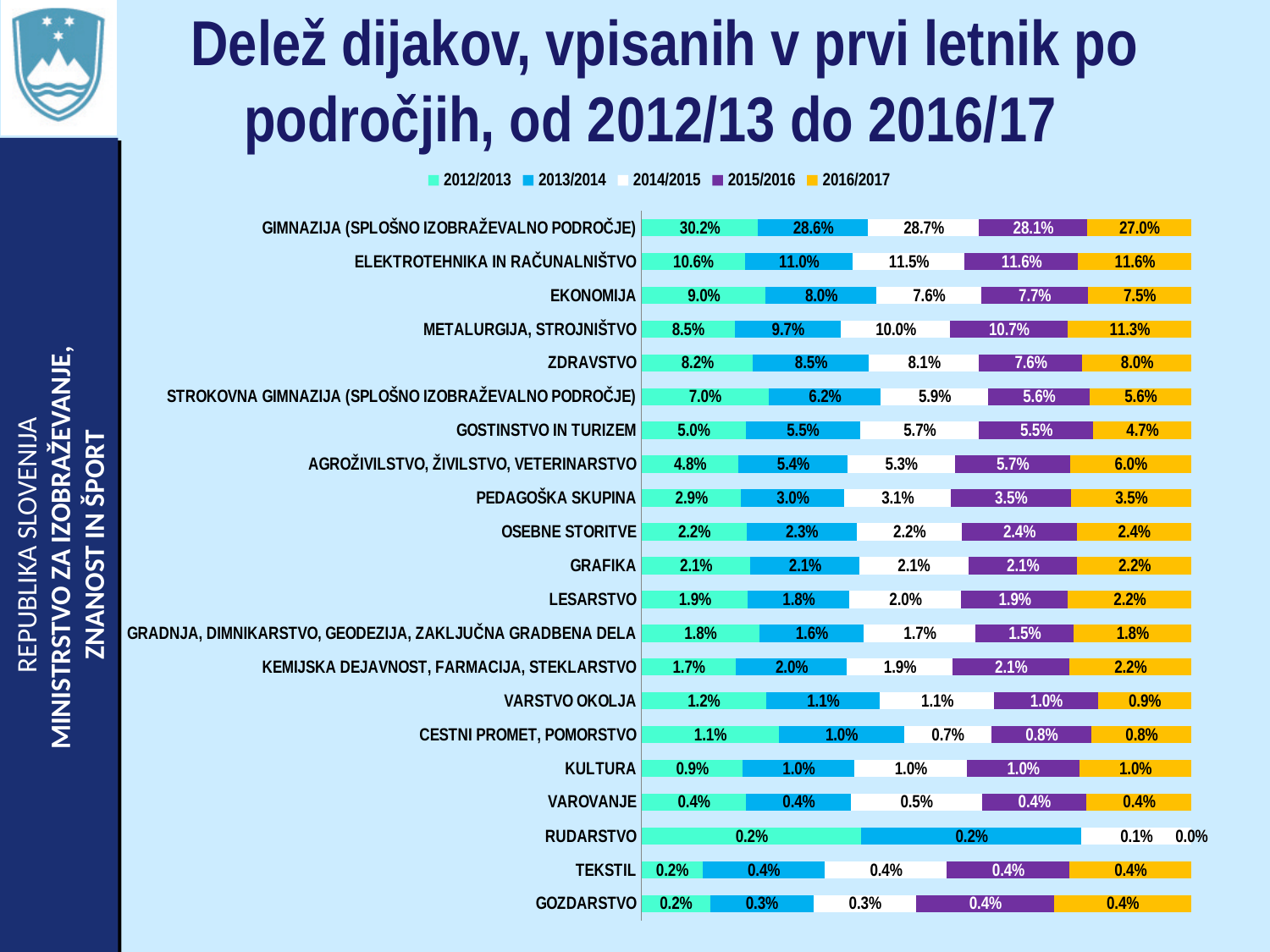
What is the value for METALURGIJA, STROJNIŠTVO in 2016/2017? 11.3% What is the difference between the 2012/2013 and 2016/2017 values for GIMNAZIJA (SPLOŠNO IZOBRAŽEVALNO PODROČJE)? 3.2 percentage points How many series does the legend list? 5 Which colour represents the 2016/2017 series in the legend? Yellow/orange Do the values for METALURGIJA, STROJNIŠTVO rise or fall from 2012/2013 to 2016/2017? Rise What is the value for GIMNAZIJA (SPLOŠNO IZOBRAŽEVALNO PODROČJE) in 2012/2013? 30.2% Which is larger in 2016/2017: ELEKTROTEHNIKA IN RAČUNALNIŠTVO or EKONOMIJA? ELEKTROTEHNIKA IN RAČUNALNIŠTVO What kind of chart is shown on the slide? Stacked horizontal bar chart Which category has the highest value in 2016/2017? GIMNAZIJA (SPLOŠNO IZOBRAŽEVALNO PODROČJE) What is the value for ZDRAVSTVO in 2015/2016? 7.6% What is the value for RUDARSTVO in 2016/2017? 0.0% How many categories (fields) are shown in the chart? 21